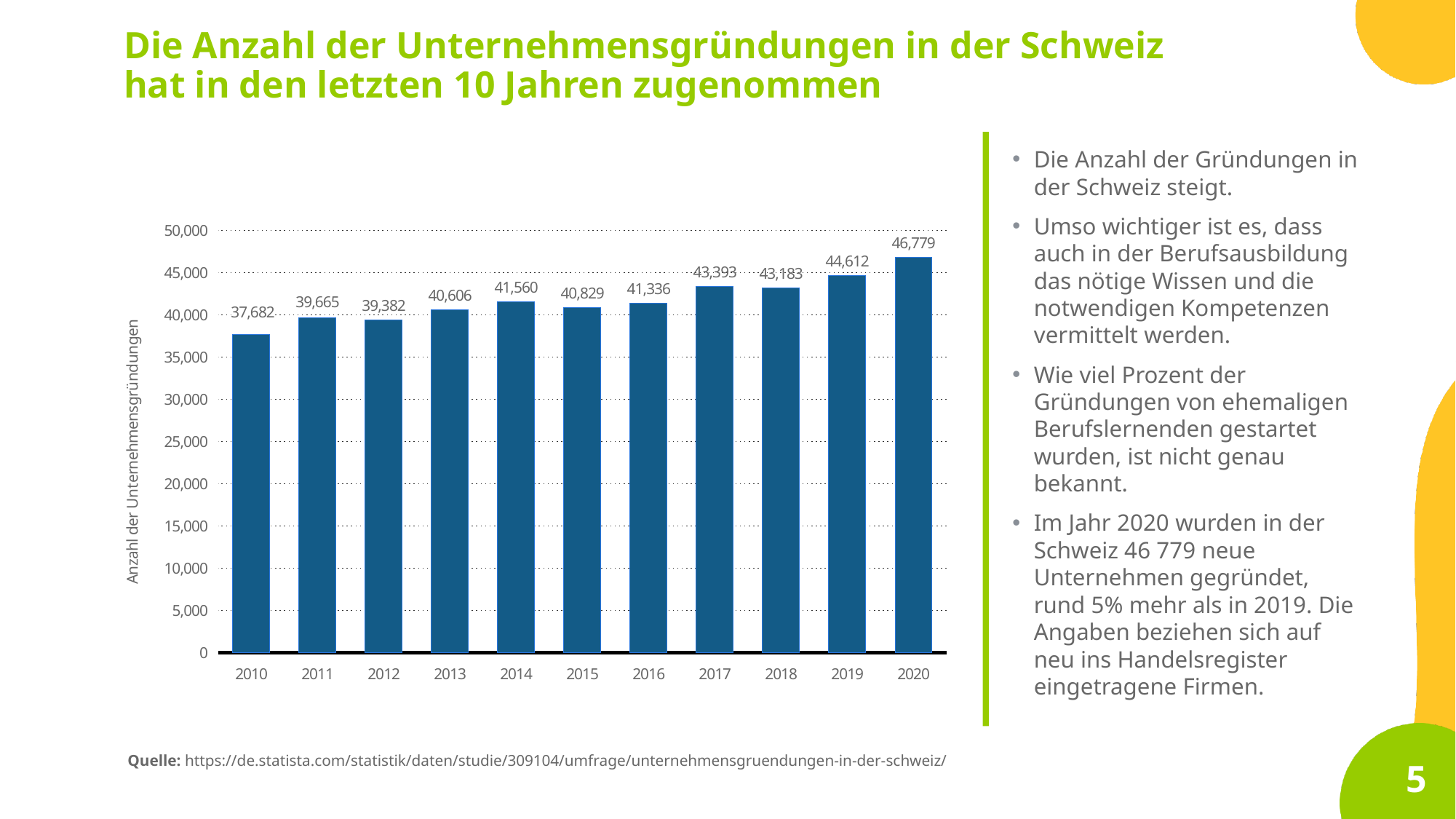
How many years are shown on the x axis? 11 Is the value for 2012 greater or less than 40,000? less Which year has the highest number of company foundations? 2020 What kind of chart is shown on the slide? bar chart What is the number of company foundations in Switzerland in 2010? 37,682 What is the value shown for 2016? 41,336 What is the label of the vertical axis? Anzahl der Unternehmensgründungen What is the difference between the values for 2020 and 2019? 2,167 Which year has the lowest number of company foundations? 2010 What is the difference between the values for 2014 and 2013? 954 What is the value shown for 2019? 44,612 Which year has a larger value, 2017 or 2018? 2017